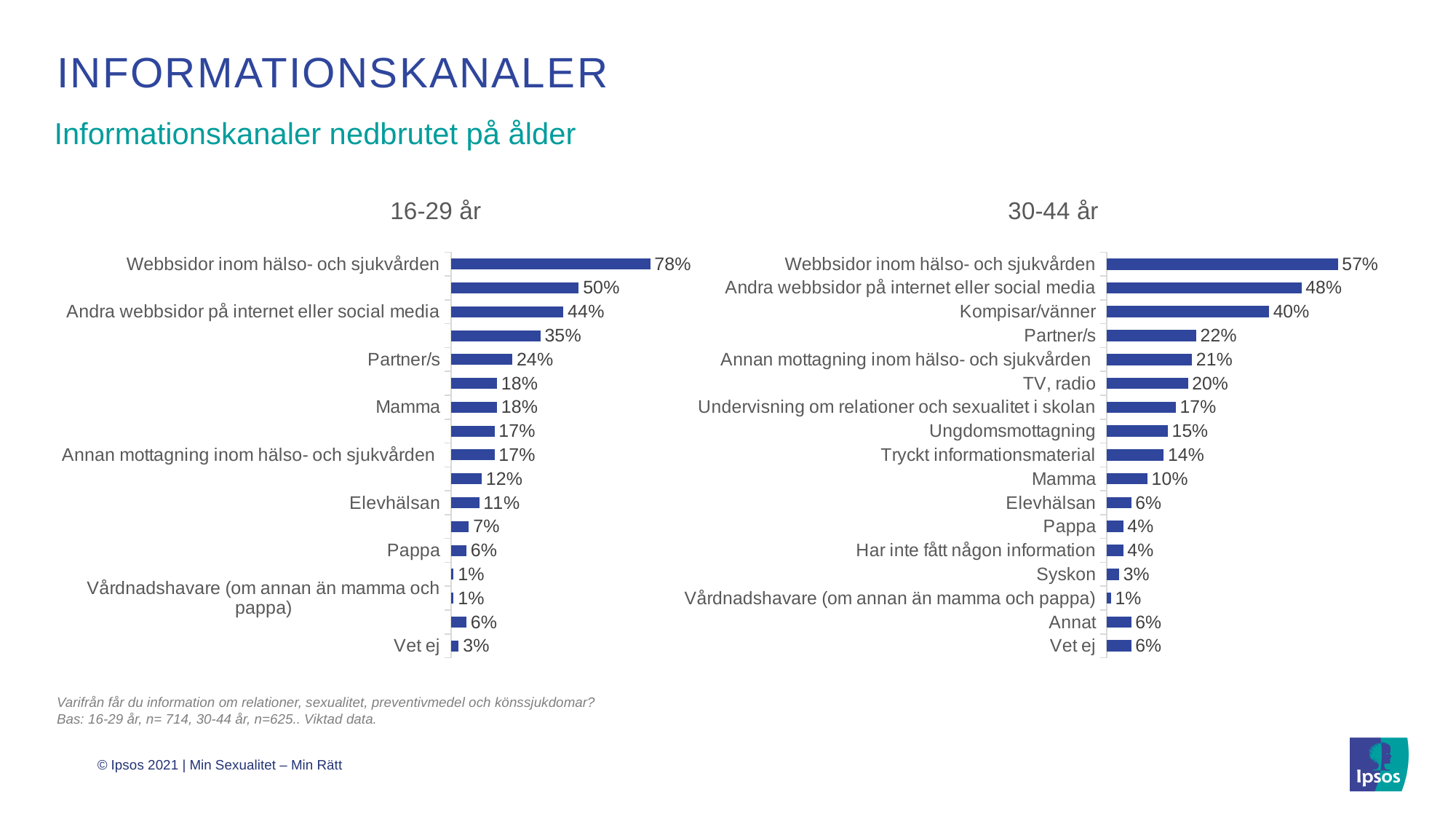
In the 30-44 år chart, what is the difference between the values for Partner/s and Pappa? 18 percentage points In the 16-29 år chart, what is the value for Webbsidor inom hälso- och sjukvården? 78% In the 16-29 år chart, what is the value for Elevhälsan? 11% In the 30-44 år chart, which category has the lowest value? Vårdnadshavare (om annan än mamma och pappa) What is the subtitle shown above the two charts? Informationskanaler nedbrutet på ålder What type of chart is used for the 16-29 år data? Bar chart In the 30-44 år chart, what is the value for Kompisar/vänner? 40% In the 30-44 år chart, which category has the highest value? Webbsidor inom hälso- och sjukvården How many bars are shown in the 30-44 år chart? 17 What is the difference between the value for Webbsidor inom hälso- och sjukvården in the 16-29 år chart and in the 30-44 år chart? 21 percentage points In the 30-44 år chart, what is the value for TV, radio? 20% Is the value for Mamma higher in the 16-29 år chart or in the 30-44 år chart? 16-29 år